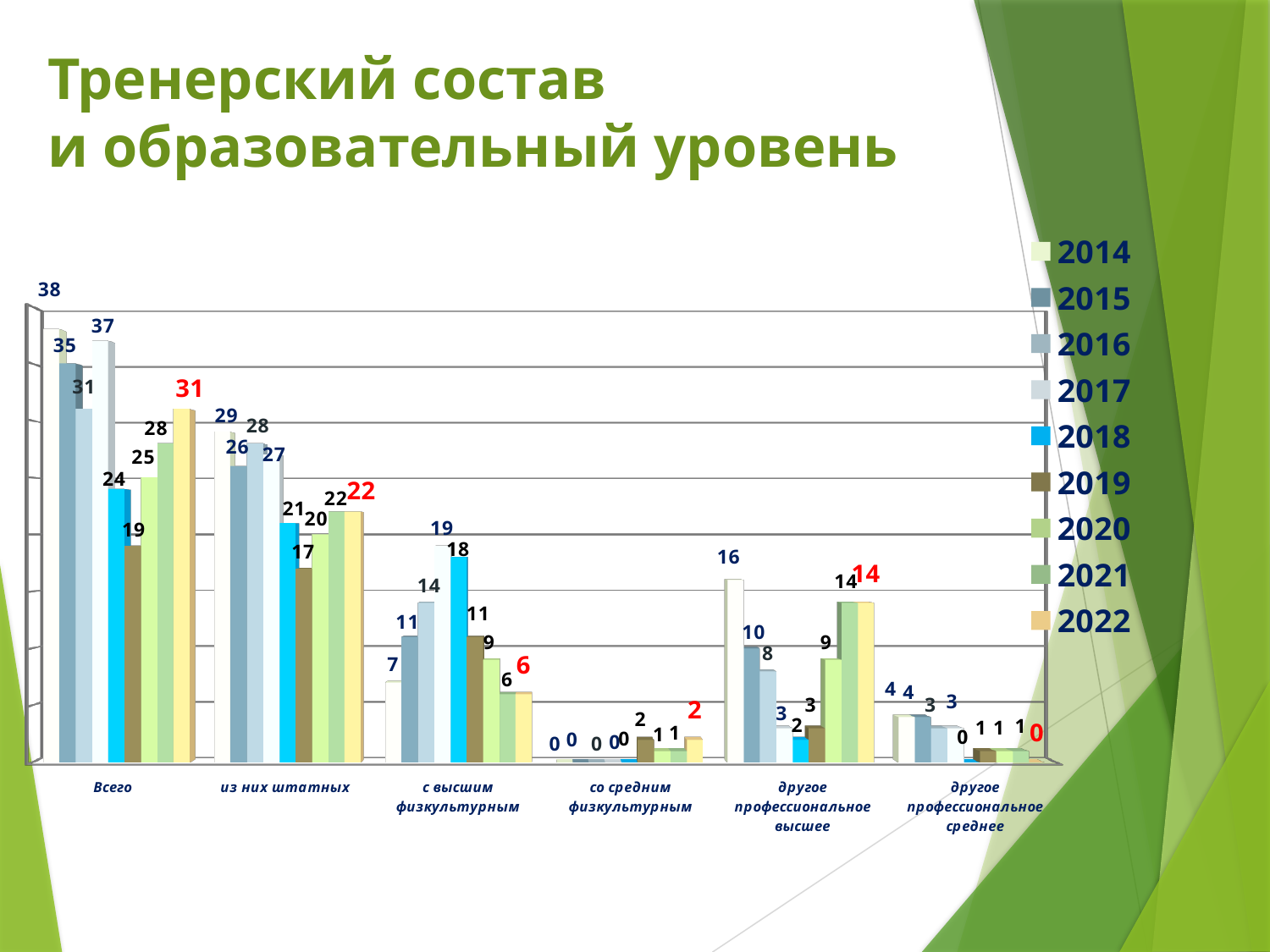
Which year has the highest value in the 'Всего' category? 2014 What is the value for 2014 in the 'Всего' category? 38 In the 'другое профессиональное высшее' category, which is larger: the value for 2014 or for 2021? 2014 Which year has the lowest value in the 'Всего' category? 2019 How many series (years) does the legend list? 9 What is the value for 2022 in the 'Всего' category? 31 How many categories are shown along the x axis? 6 What kind of chart is shown on the slide? bar chart What is the value for 2022 in the 'другое профессиональное высшее' category? 14 Which year is listed first in the legend? 2014 What is the difference between the 2014 and 2019 values in the 'Всего' category? 19 What is the value for 2017 in the 'с высшим физкультурным' category? 19